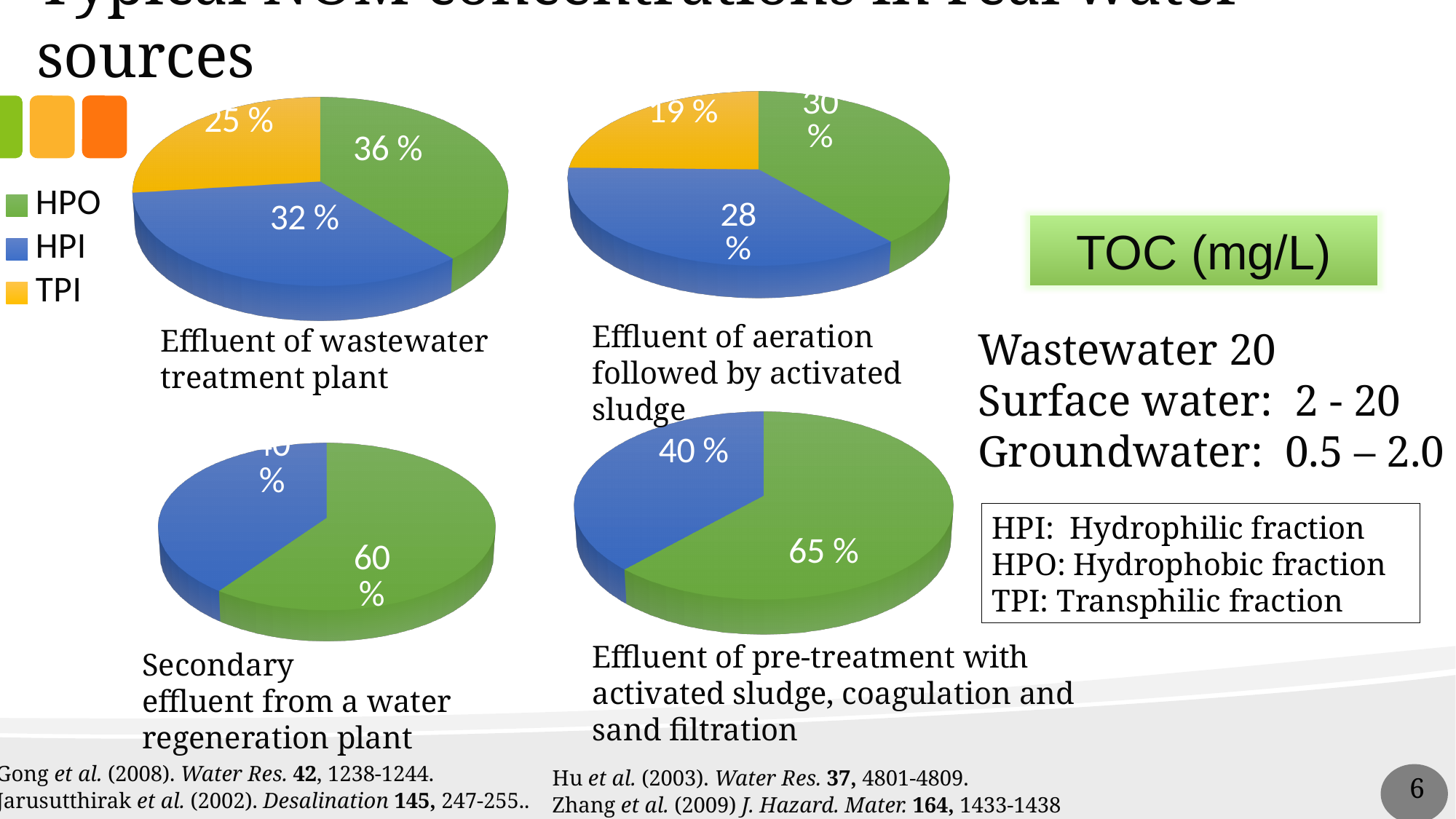
In the 'Effluent of pre-treatment with activated sludge, coagulation and sand filtration' pie chart, what percentage is the HPO slice? 65 % In the 'Effluent of wastewater treatment plant' pie chart, how many percentage points larger is the HPO slice than the TPI slice? 11 % In the 'Effluent of aeration followed by activated sludge' pie chart, which fraction has the smallest slice? TPI In the 'Effluent of aeration followed by activated sludge' pie chart, what percentage is the TPI slice? 19 % In the 'Effluent of wastewater treatment plant' pie chart, which fraction has the largest slice? HPO In the 'Effluent of wastewater treatment plant' pie chart, what percentage is the HPI slice? 32 % In the 'Effluent of wastewater treatment plant' pie chart, what percentage is the HPO slice? 36 % In the 'Effluent of pre-treatment with activated sludge, coagulation and sand filtration' pie chart, which is larger, the HPO slice or the HPI slice? HPO How many fractions does the legend list for the pie charts? 3 In the 'Effluent of aeration followed by activated sludge' pie chart, what percentage is the HPO slice? 30 % What type of chart is used to show the NOM fractions on this slide? Pie chart In the 'Secondary effluent from a water regeneration plant' pie chart, what percentage is the HPO slice? 60 %